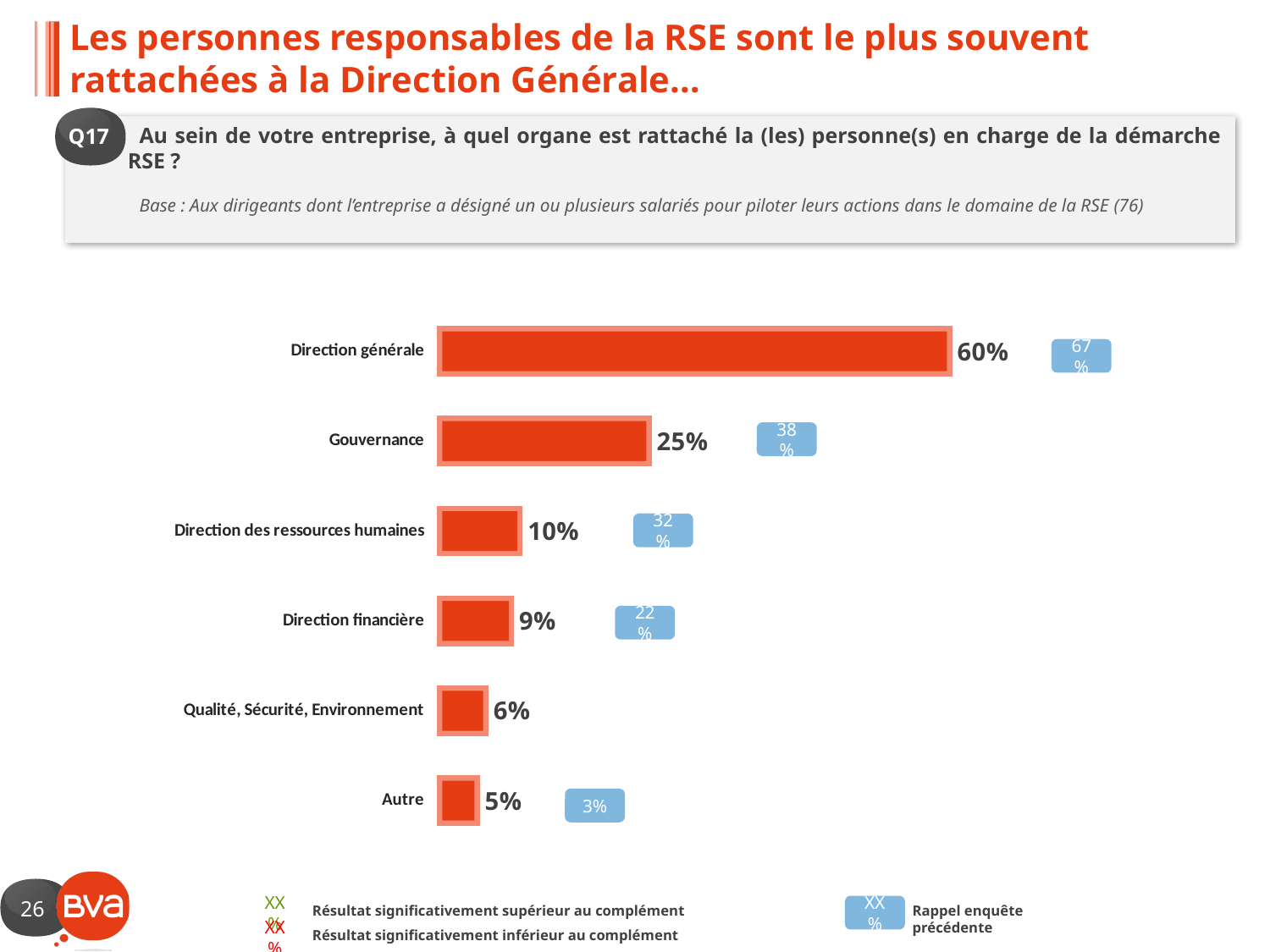
What is the difference between the values for Direction générale and Gouvernance? 35% What percentage is shown for Qualité, Sécurité, Environnement? 6% Which is larger, the value for Gouvernance or the value for Direction financière? Gouvernance What percentage is shown for Gouvernance? 25% How many categories are shown in the chart? 6 What previous survey value (blue box) is shown next to Direction générale? 67% What percentage is shown for Direction générale? 60% Which category has the lowest value in the chart? Autre What is the difference between the values for Direction des ressources humaines and Direction financière? 1% What percentage is shown for Direction des ressources humaines? 10% What kind of chart is shown on the slide? Bar chart Which category has the highest value in the chart? Direction générale